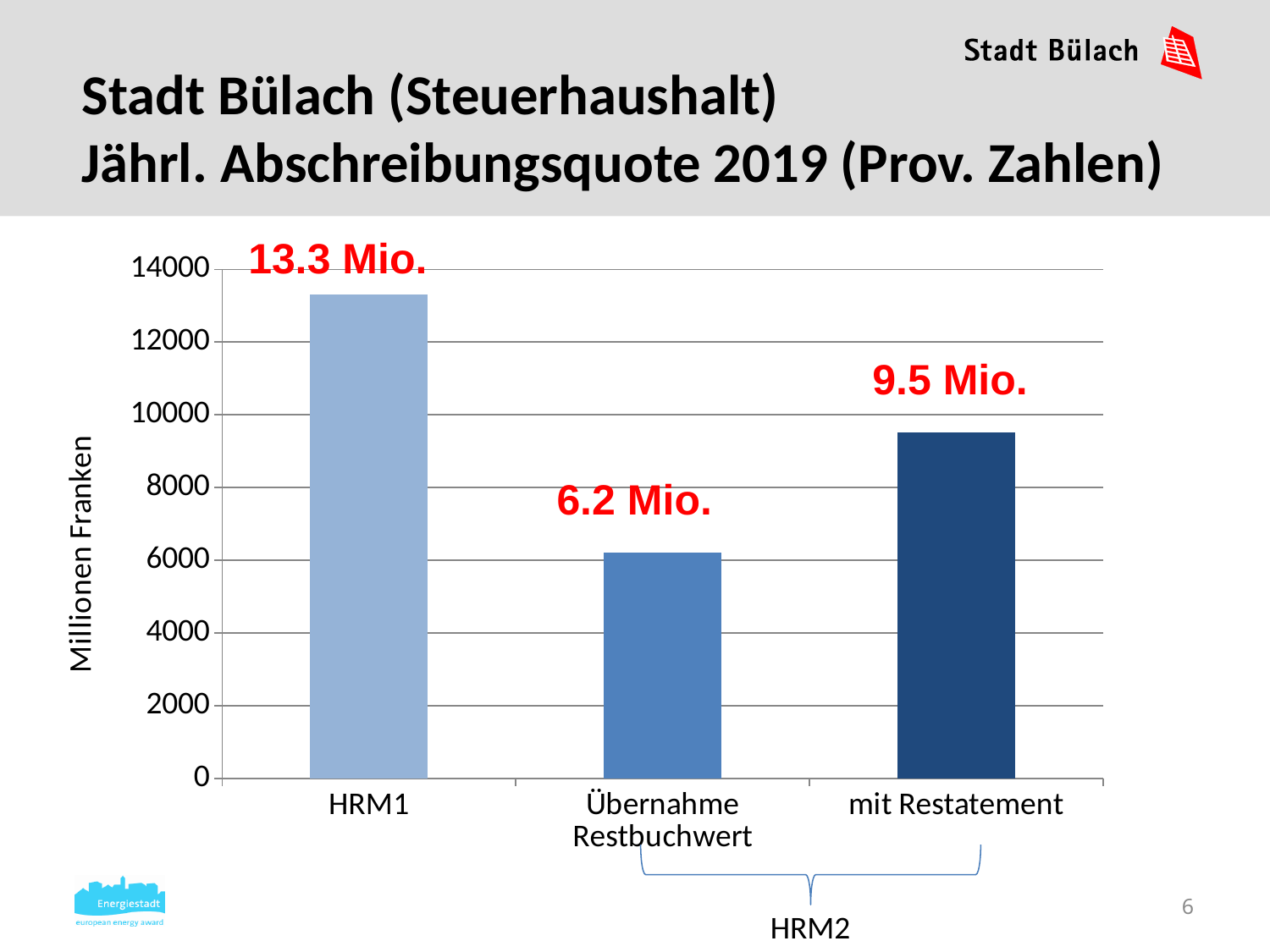
What value is labelled for the mit Restatement bar? 9.5 Mio. Which is larger, the value for mit Restatement or the value for Übernahme Restbuchwert? mit Restatement Which category has the highest bar? HRM1 Which category has the lowest bar? Übernahme Restbuchwert Is the value for HRM1 greater or less than 12000 on the axis? greater What kind of chart is shown on the slide? bar chart How many bars are shown in the chart? 3 What is the difference between the labelled values for mit Restatement and Übernahme Restbuchwert? 3.3 Mio. What value is labelled for the HRM1 bar? 13.3 Mio. What is the difference between the labelled values for HRM1 and Übernahme Restbuchwert? 7.1 Mio. What is the label of the vertical axis? Millionen Franken What value is labelled for the Übernahme Restbuchwert bar? 6.2 Mio.